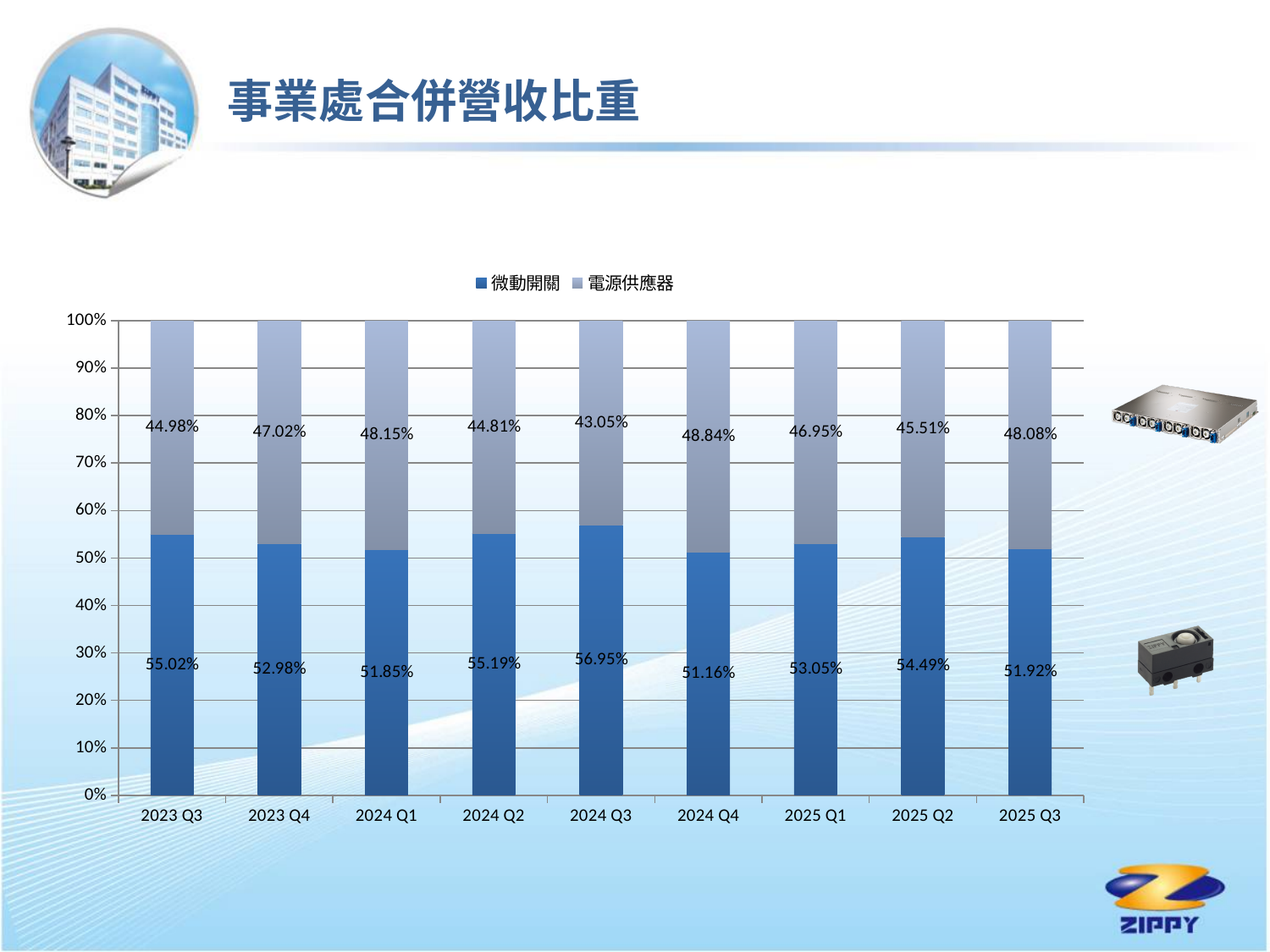
What is the value for 微動開關 in 2023 Q4? 52.98% What is the difference between the 微動開關 and 電源供應器 shares in 2024 Q4? 2.32% What is the value for 電源供應器 in 2025 Q3? 48.08% What is the total of the stacked bar for 2023 Q3? 100% What is the value for 微動開關 in 2024 Q3? 56.95% How many series does the legend list? 2 In which quarter is the 微動開關 share highest? 2024 Q3 In which quarter is the 電源供應器 share lowest? 2024 Q3 How many quarters are shown on the x axis? 9 In which quarter is the 電源供應器 share highest? 2024 Q4 What kind of chart is shown on the slide? Stacked bar chart Which is larger in 2025 Q2, the 微動開關 share or the 電源供應器 share? 微動開關